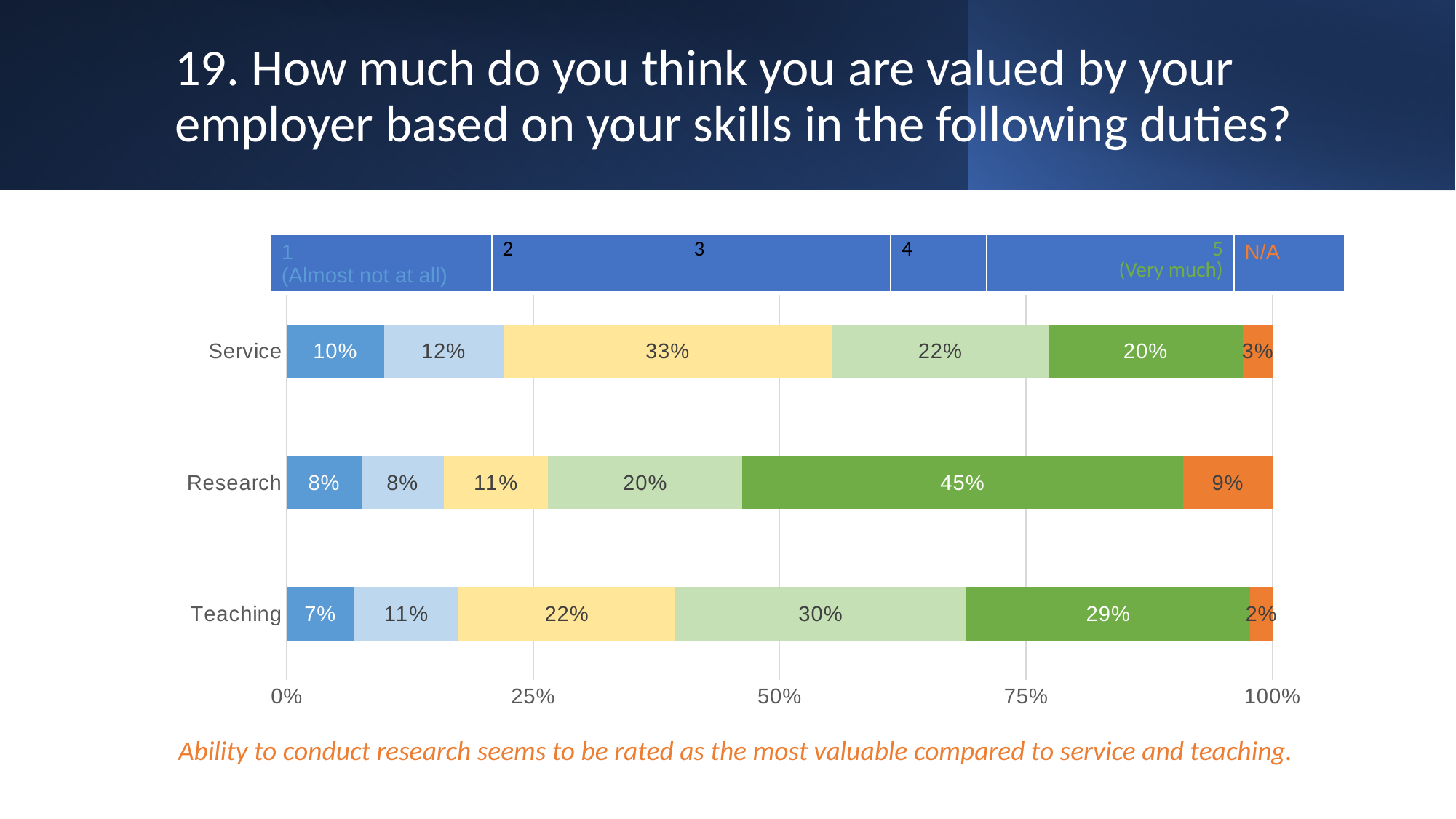
What percentage of respondents rated Research as 5 (Very much)? 45% What is the difference between the 5 (Very much) share for Research and for Service? 25% How many series does the legend list? 6 Which duty has the lowest share of respondents rating it 1 (Almost not at all)? Teaching What percentage of respondents rated Service as 3? 33% Is the share of respondents rating Teaching as 4 larger or smaller than the share rating Service as 4? larger What percentage of respondents answered N/A for Teaching? 2% Which duty has the highest share of respondents rating it 5 (Very much)? Research What is the combined share of respondents rating Research as 4 or 5 (Very much)? 65% How many duties (categories) are shown in the chart? 3 What type of chart is shown on the slide? stacked bar chart Which colour represents the N/A responses in the chart? orange